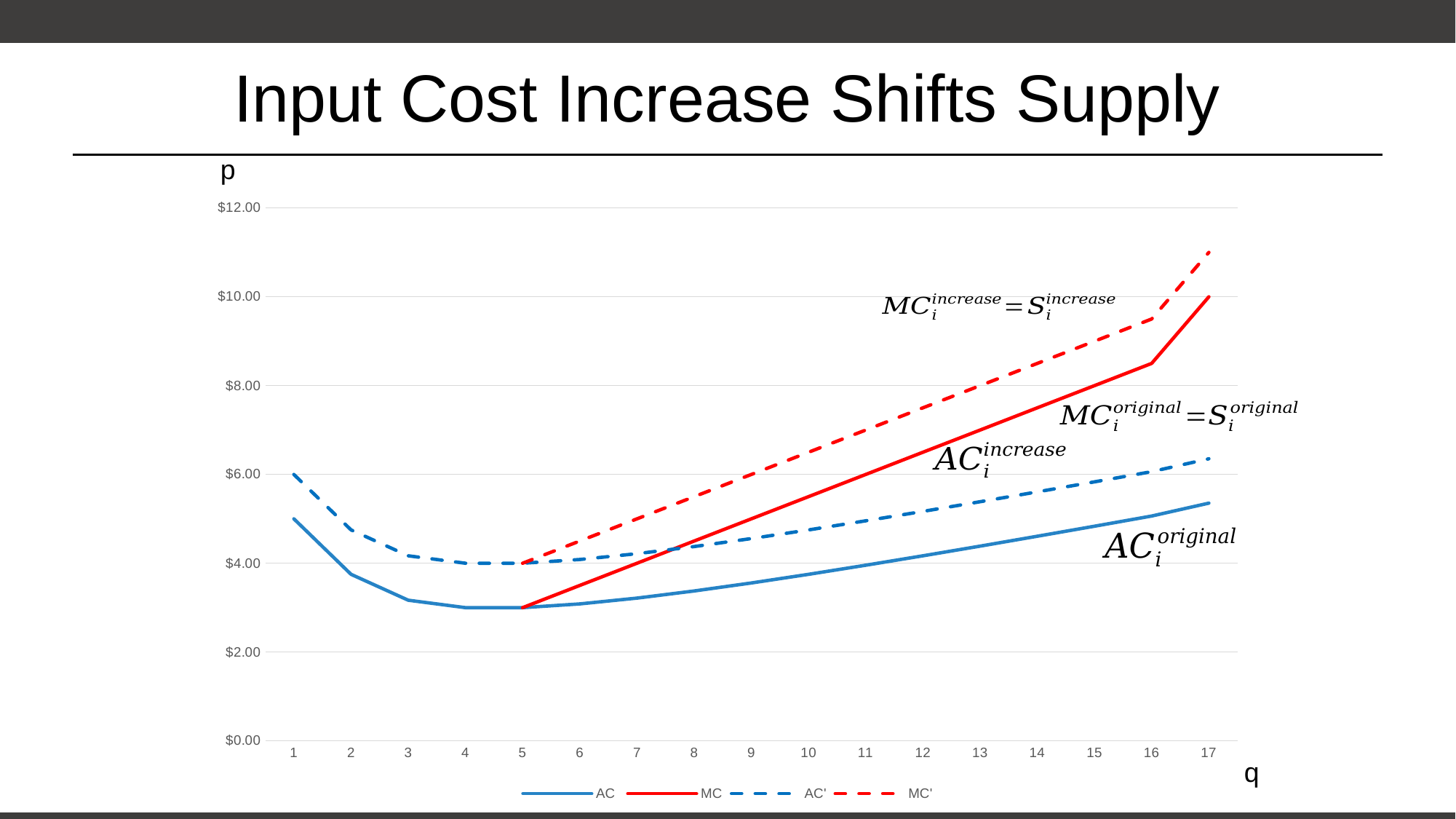
What is the value of the MC' series at q = 5? $4.00 Does the MC series rise or fall as q increases from 5 to 17? rise Is the value of the MC series at q = 16 greater or less than $8.00? greater What is the value of the AC' series at q = 1? $6.00 What kind of chart is shown on the slide? line chart What is the title of the slide containing the chart? Input Cost Increase Shifts Supply How many series does the legend list? 4 How many points are labelled along the q axis? 17 Is the value of the AC series at q = 17 greater or less than $6.00? less What is the value of the MC series at q = 17? $10.00 At q = 17, which series has the higher value, MC or MC'? MC' Is the value of the MC' series at q = 17 greater or less than $10.00? greater